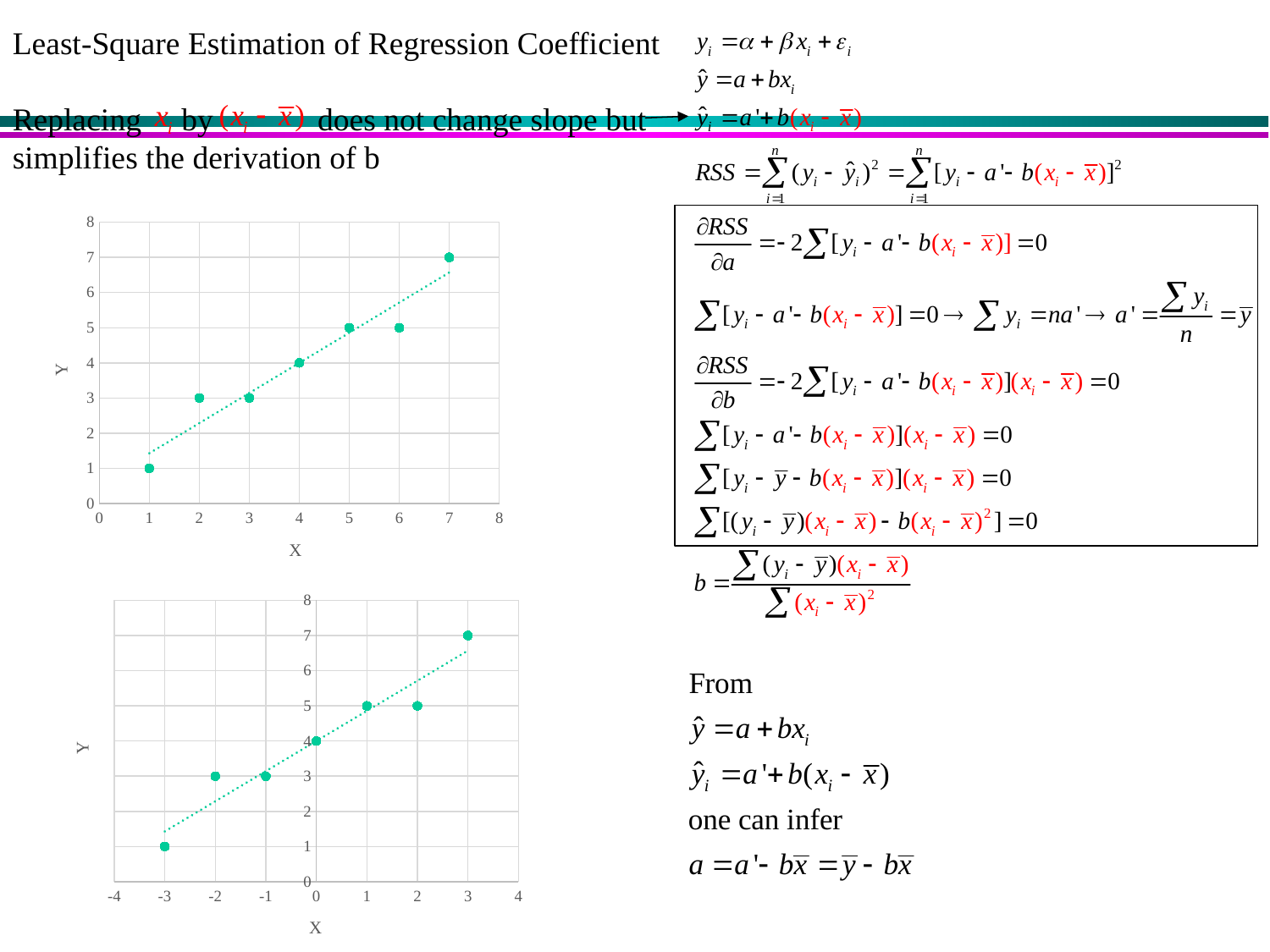
In the top chart, what is the Y value of the point at X = 4? 4 In the bottom chart, what is the Y value of the point at X = -3? 1 In the top chart, what is the difference between the Y values at X = 7 and X = 1? 6 How many data points are plotted in the bottom chart? 7 What kind of chart is the top chart on the slide? scatter chart In the bottom chart, which X value has the lowest Y value? -3 What is the label on the horizontal axis of the bottom chart? X In the bottom chart, what is the Y value of the point at X = 0? 4 In the top chart, which X value has the highest Y value? 7 In the top chart, what is the Y value of the point at X = 7? 7 How many data points are plotted in the top chart? 7 In the top chart, do the Y values generally rise or fall as X increases? rise